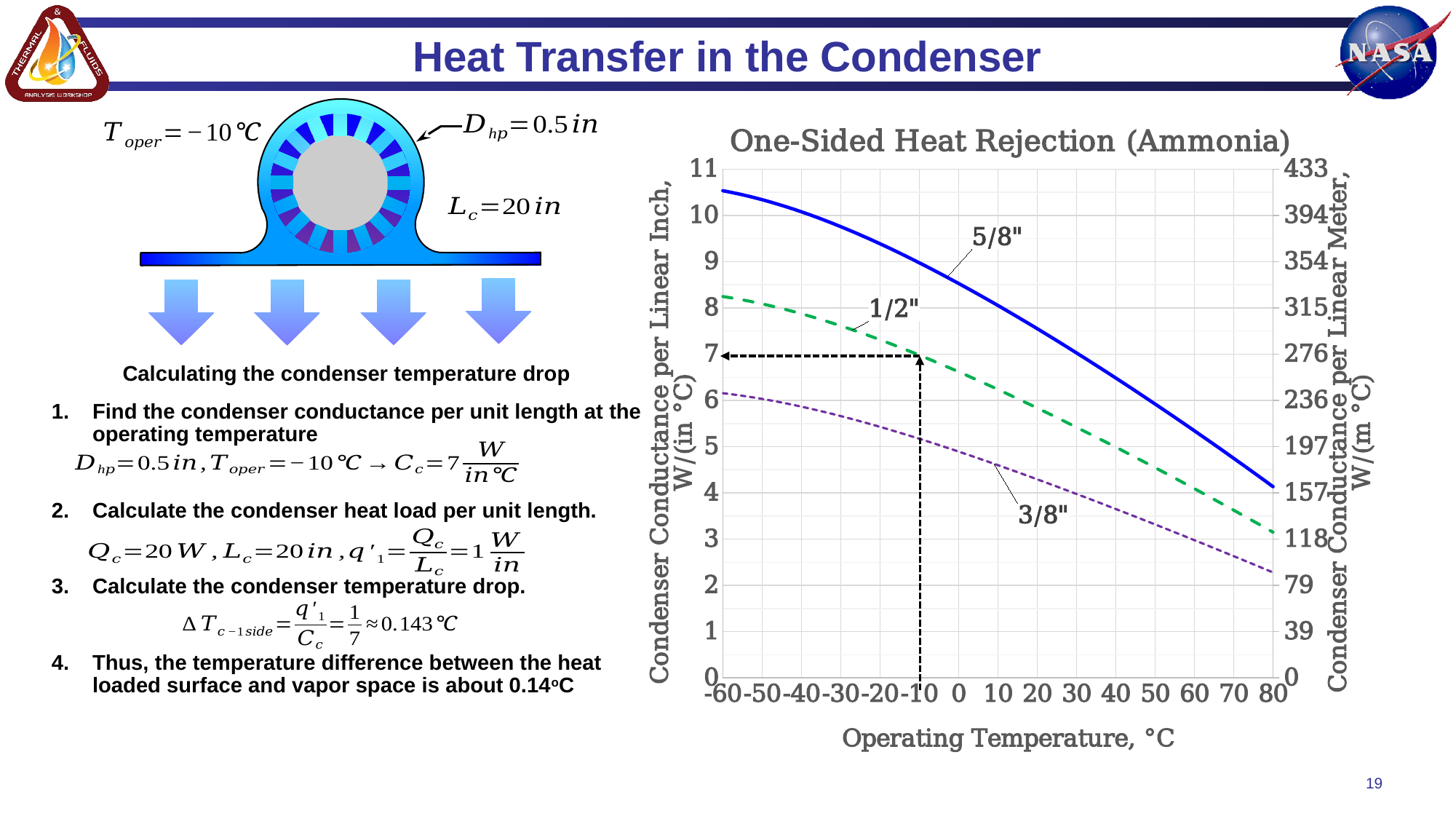
Is the condenser conductance for the 3/8" pipe at 80 °C greater or less than 3 W/(in °C)? less Is the condenser conductance for the 5/8" pipe at -60 °C greater or less than 10 W/(in °C)? greater How many series (heat pipe diameters) are plotted on the chart? 3 Which series has the highest condenser conductance across the temperature range? 5/8" Is the condenser conductance for the 3/8" pipe at -60 °C greater or less than 5 W/(in °C)? greater Do the condenser conductance values rise or fall as operating temperature increases? fall At 0 °C, which has the larger condenser conductance, the 5/8" pipe or the 3/8" pipe? 5/8" What is the label of the x axis of the chart? Operating Temperature, °C What is the title of the chart? One-Sided Heat Rejection (Ammonia) Which series has the lowest condenser conductance across the temperature range? 3/8" What type of chart is shown on the slide? line chart According to the dashed arrow on the chart, what is the condenser conductance per linear inch for the 1/2" pipe at -10 °C? 7